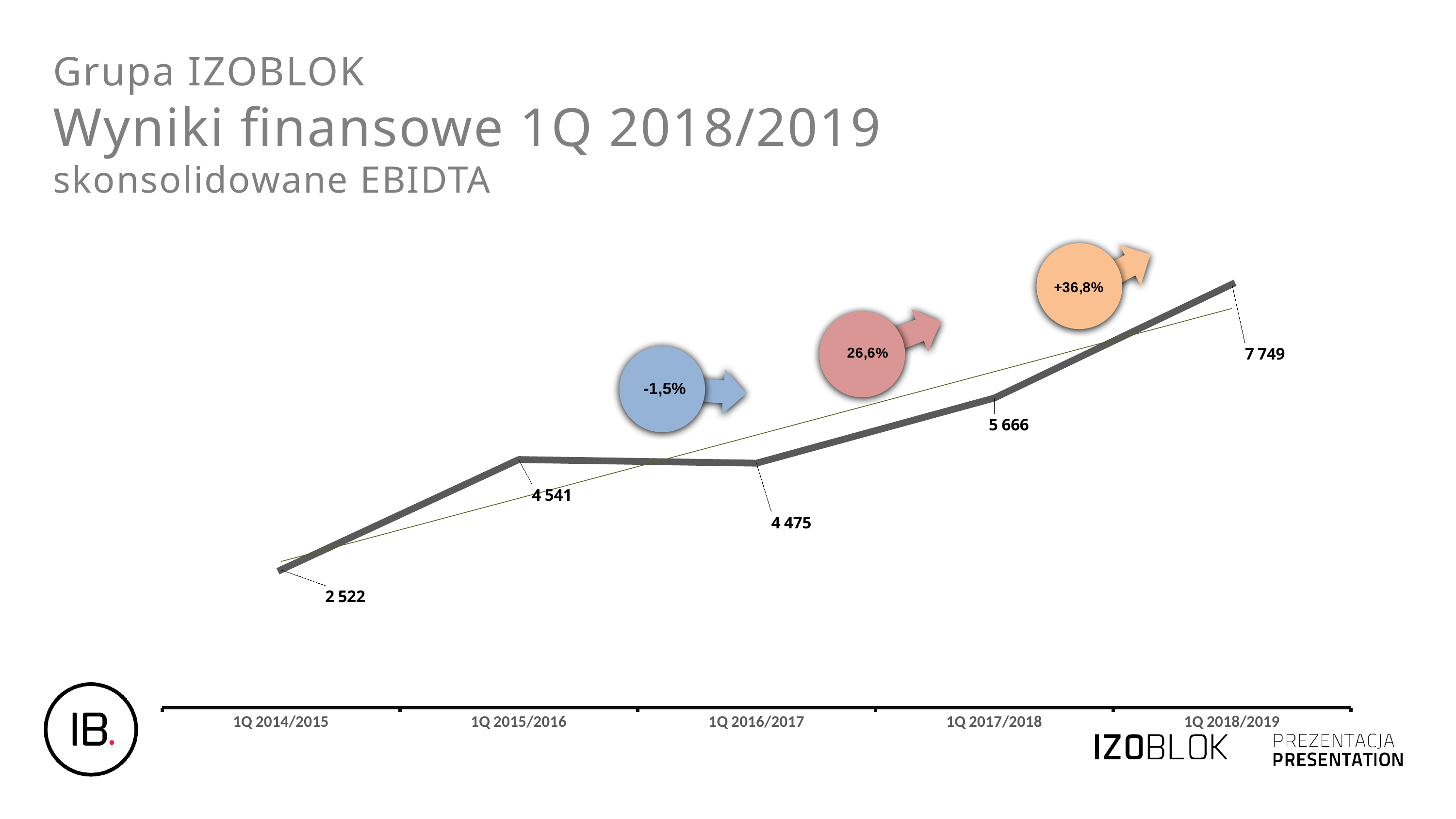
What is the EBITDA value for 1Q 2015/2016? 4 541 What is the difference between the EBITDA values for 1Q 2018/2019 and 1Q 2017/2018? 2 083 Which period has the lowest EBITDA value? 1Q 2014/2015 What percentage change is shown in the orange circle between 1Q 2017/2018 and 1Q 2018/2019? +36,8% What is the EBITDA value for 1Q 2014/2015? 2 522 What kind of chart is shown on the slide? Line chart Which is larger, the EBITDA value for 1Q 2015/2016 or for 1Q 2016/2017? 1Q 2015/2016 What is the EBITDA value for 1Q 2018/2019? 7 749 Which period has the highest EBITDA value? 1Q 2018/2019 What is the EBITDA value for 1Q 2017/2018? 5 666 How many periods are plotted on the chart? 5 What is the EBITDA value for 1Q 2016/2017? 4 475